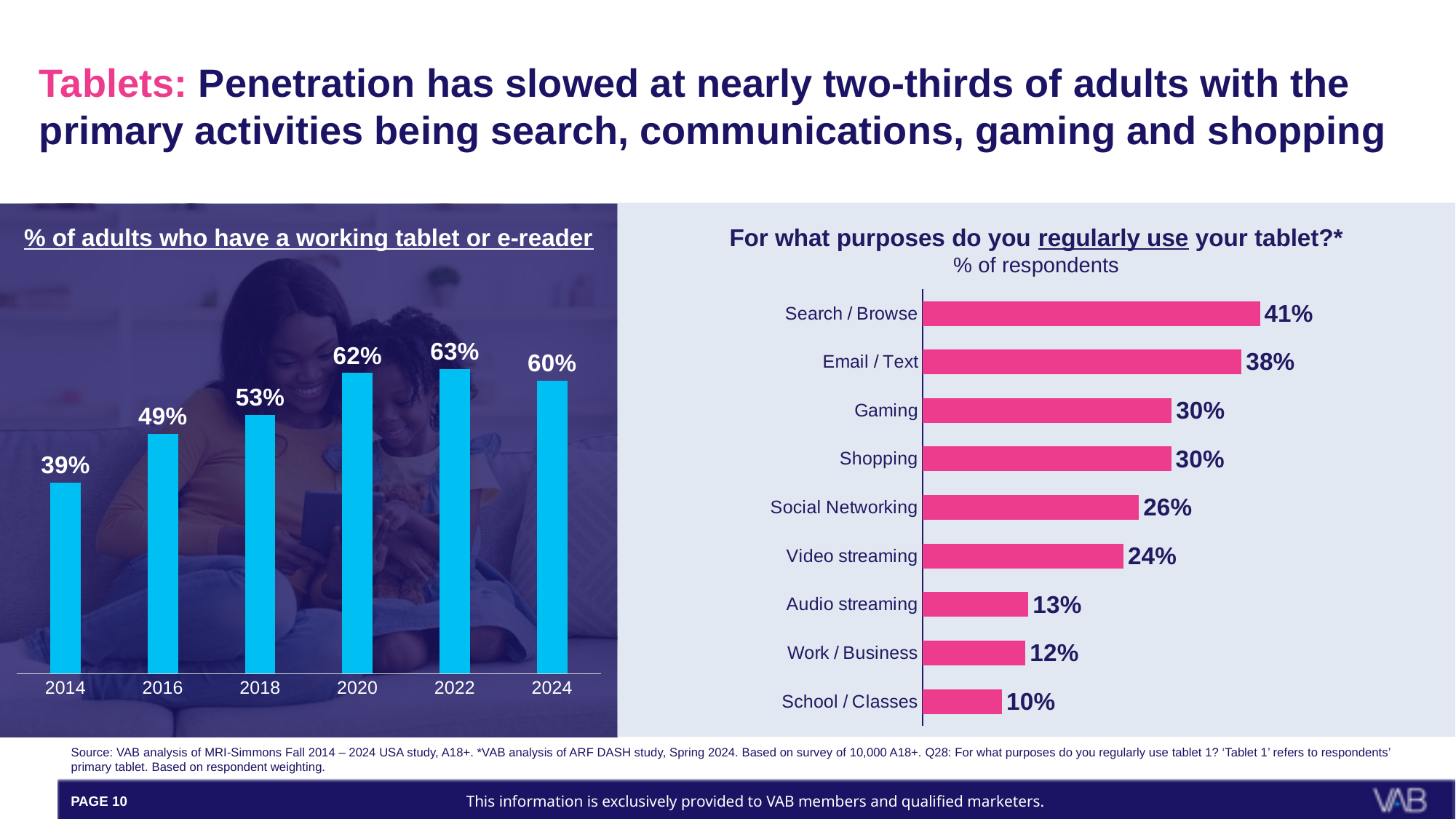
In the left chart '% of adults who have a working tablet or e-reader', what is the difference between the 2024 value and the 2014 value? 21% In the right chart 'For what purposes do you regularly use your tablet?', which is larger: Video streaming or Audio streaming? Video streaming In the right chart 'For what purposes do you regularly use your tablet?', what is the difference between Search / Browse and Email / Text? 3% What kind of chart is the right chart 'For what purposes do you regularly use your tablet?'? bar chart In the right chart 'For what purposes do you regularly use your tablet?', what is the value for Social Networking? 26% In the right chart 'For what purposes do you regularly use your tablet?', how many purposes are listed? 9 In the left chart '% of adults who have a working tablet or e-reader', do the values rise or fall from 2014 to 2022? rise In the left chart '% of adults who have a working tablet or e-reader', how many years are shown on the x axis? 6 In the right chart 'For what purposes do you regularly use your tablet?', which purpose has the highest value? Search / Browse In the left chart '% of adults who have a working tablet or e-reader', which year has the highest value? 2022 In the left chart '% of adults who have a working tablet or e-reader', what is the value for 2014? 39% In the right chart 'For what purposes do you regularly use your tablet?', which purpose has the lowest value? School / Classes